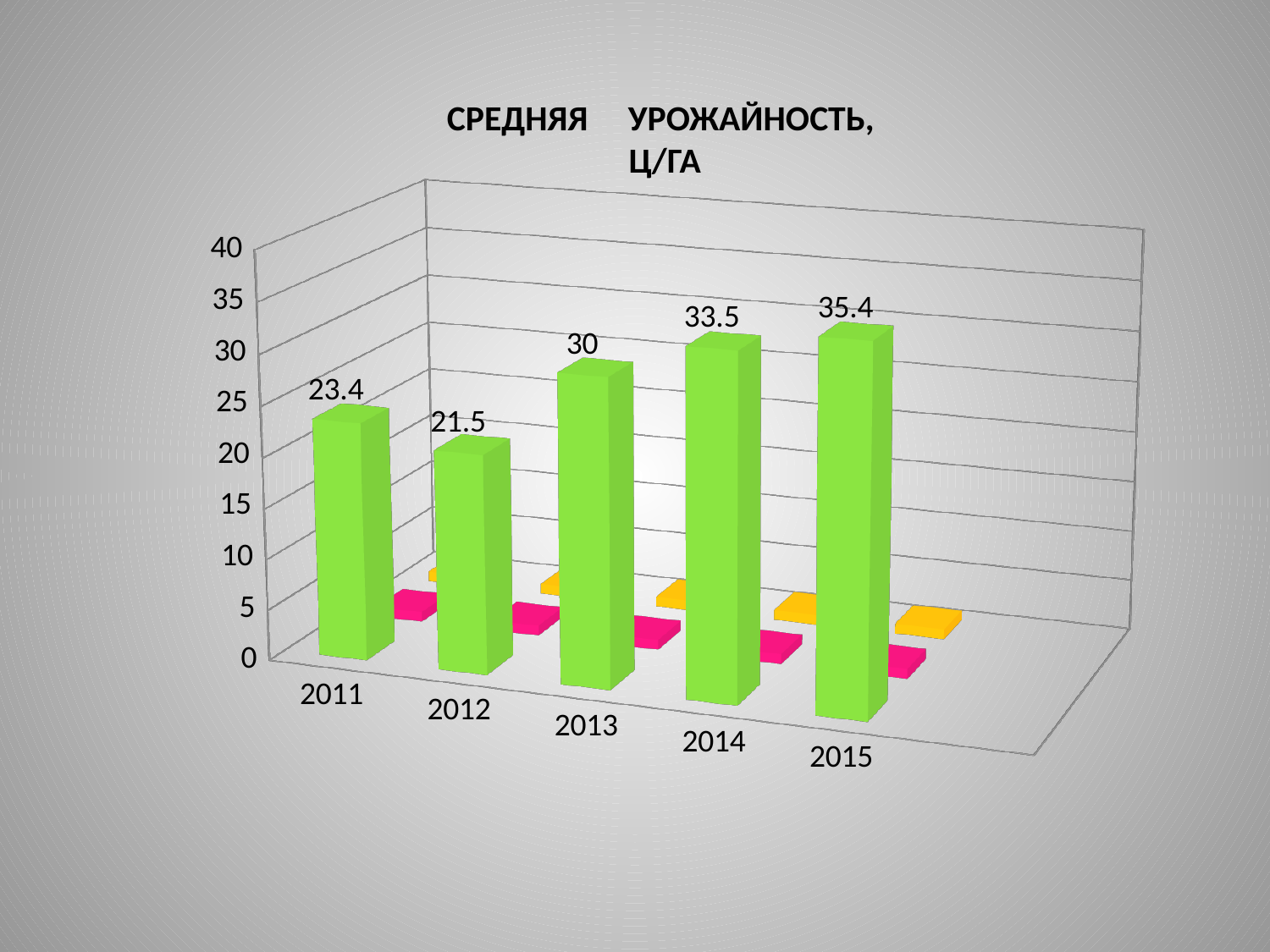
What is the value shown for 2013 in the chart? 30 Is the labelled value for 2014 greater or less than 30? greater What is the value shown for 2011 in the chart? 23.4 What is the value shown for 2014 in the chart? 33.5 What is the difference between the labelled values for 2015 and 2011? 12 Which is larger, the labelled value for 2012 or for 2013? 2013 What is the title of the chart? СРЕДНЯЯ УРОЖАЙНОСТЬ, Ц/ГА What kind of chart is shown on the slide? Bar chart Which year has the lowest labelled value in the chart? 2012 Which year has the highest labelled value in the chart? 2015 How many years are shown on the x axis of the chart? 5 What is the value shown for 2015 in the chart? 35.4